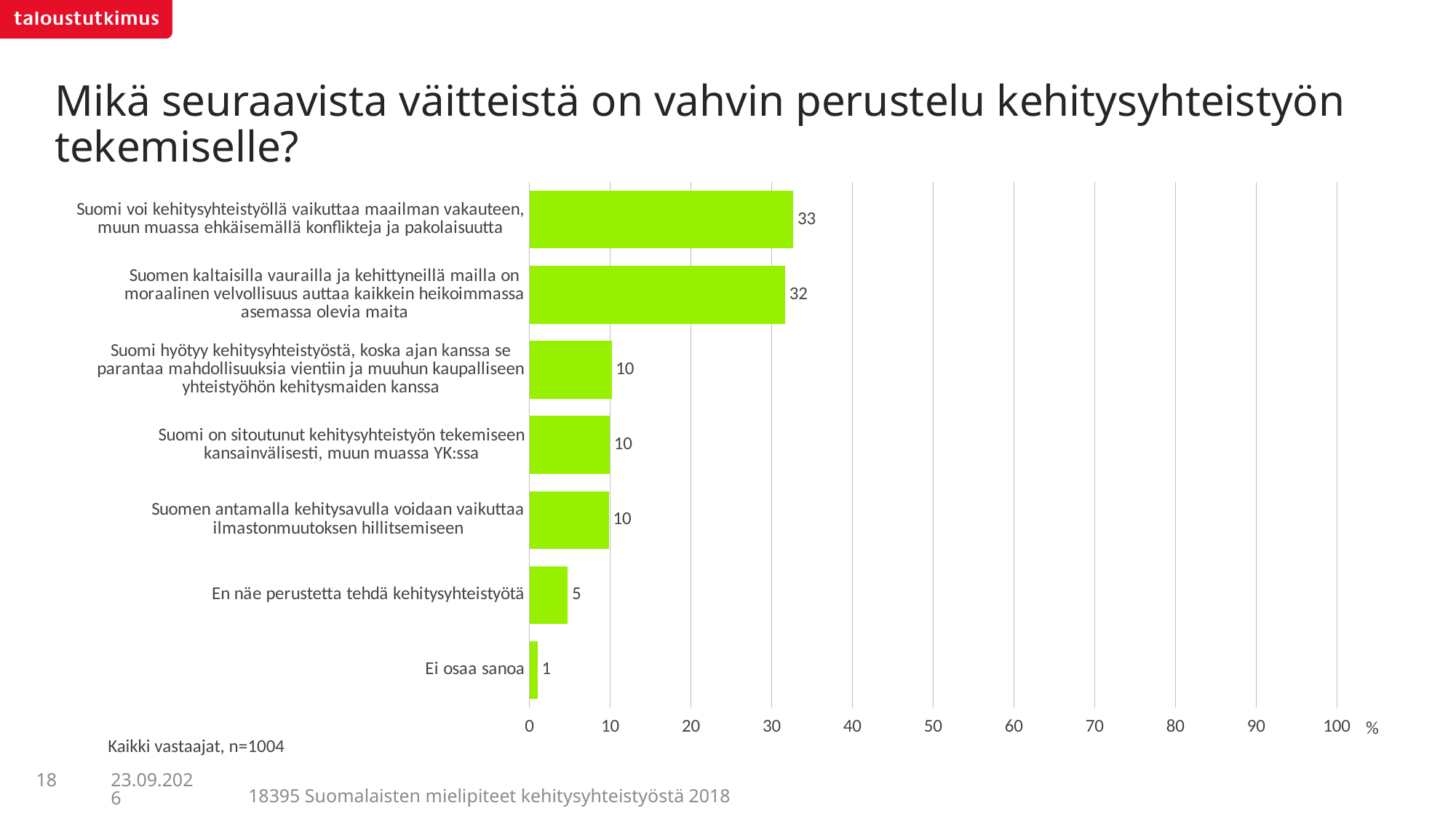
What is the value for "Suomi on sitoutunut kehitysyhteistyön tekemiseen kansainvälisesti, muun muassa YK:ssa"? 10 What is the difference between the value for "Suomen antamalla kehitysavulla voidaan vaikuttaa ilmastonmuutoksen hillitsemiseen" and the value for "En näe perustetta tehdä kehitysyhteistyötä"? 5 Which is larger: the value for "Suomi hyötyy kehitysyhteistyöstä..." or the value for "En näe perustetta tehdä kehitysyhteistyötä"? Suomi hyötyy kehitysyhteistyöstä... Which category has the highest value? Suomi voi kehitysyhteistyöllä vaikuttaa maailman vakauteen, muun muassa ehkäisemällä konflikteja ja pakolaisuutta What is the difference between the value for "Suomi voi kehitysyhteistyöllä vaikuttaa maailman vakauteen..." and the value for "Suomen kaltaisilla vaurailla ja kehittyneillä mailla on moraalinen velvollisuus..."? 1 Which category has the lowest value? Ei osaa sanoa Is the value for "Suomen kaltaisilla vaurailla ja kehittyneillä mailla on moraalinen velvollisuus..." greater or less than 20? greater How many categories are shown in the chart? 7 What kind of chart is shown on the slide? bar chart What is the value for "Ei osaa sanoa"? 1 What is the value for "En näe perustetta tehdä kehitysyhteistyötä"? 5 What is the sample size stated below the chart? n=1004